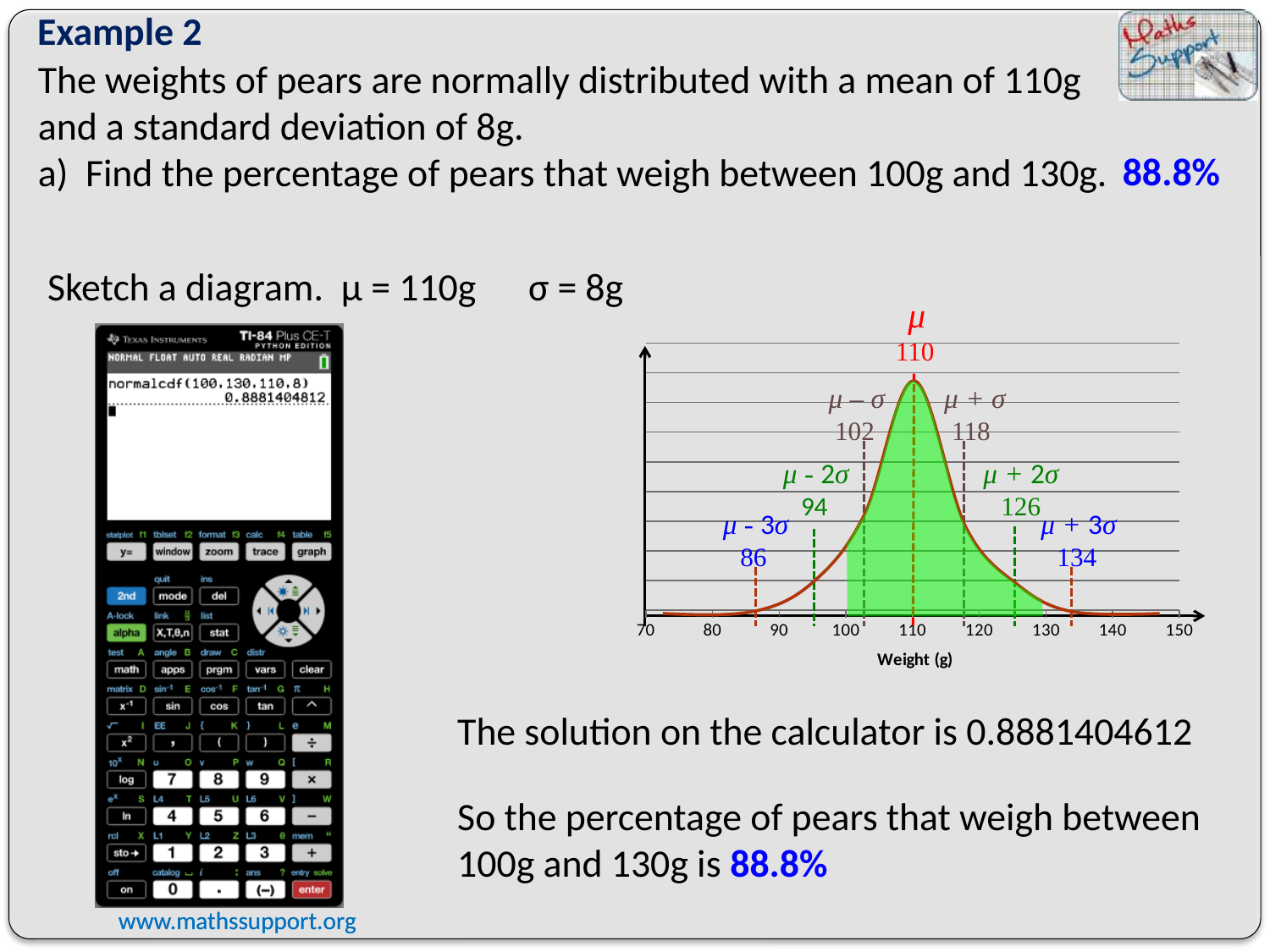
What is the label on the horizontal axis of the chart? Weight (g) What kind of chart is shown on the right of the slide? line chart (normal distribution curve) At what weight is the mean μ marked on the chart? 110 What weight is marked at μ + σ on the chart? 118 What weight is marked at μ − σ on the chart? 102 What weight is marked at μ + 2σ on the chart? 126 Which is larger, the weight marked at μ + 2σ or at μ + σ? μ + 2σ (126) How many tick labels are shown on the horizontal axis of the chart? 9 What is the difference between the weights marked at μ + 3σ and μ − 3σ? 48 At what weight does the curve reach its highest point? 110 Between which two weights on the horizontal axis is the region under the curve shaded green? 100 and 130 What weight is marked at μ − 3σ on the chart? 86